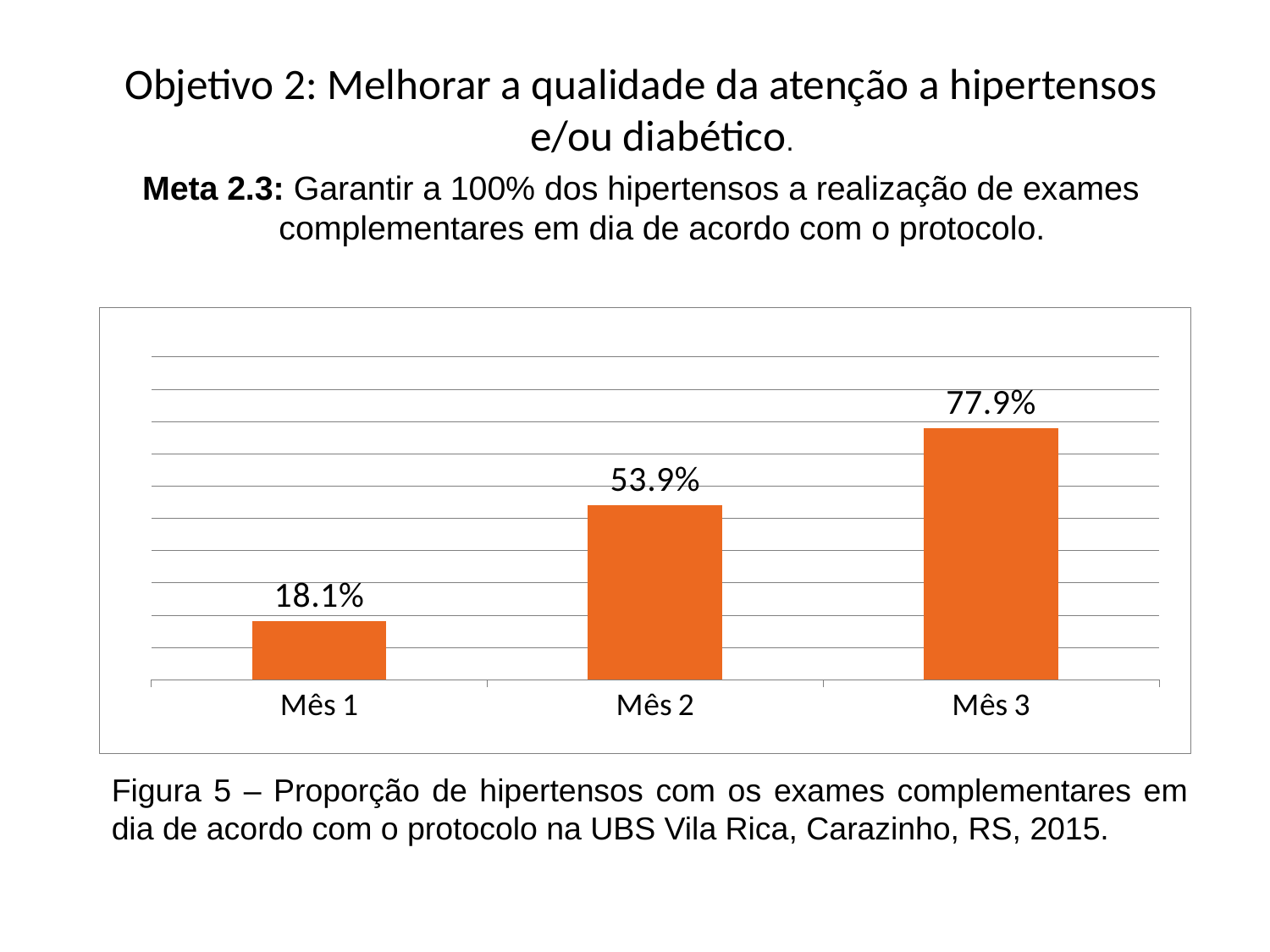
What kind of chart is shown on the slide? Bar chart What is the value for Mês 1? 18.1% What is the value for Mês 2? 53.9% Which month has the lowest value? Mês 1 Which is larger, the value for Mês 1 or the value for Mês 2? Mês 2 Do the values rise or fall from Mês 1 to Mês 3? Rise Which month has the highest value? Mês 3 What colour are the bars in the chart? Orange What is the difference between the values for Mês 3 and Mês 2? 24.0% What is the value for Mês 3? 77.9% How many categories are shown on the x axis? 3 What is the difference between the values for Mês 2 and Mês 1? 35.8%